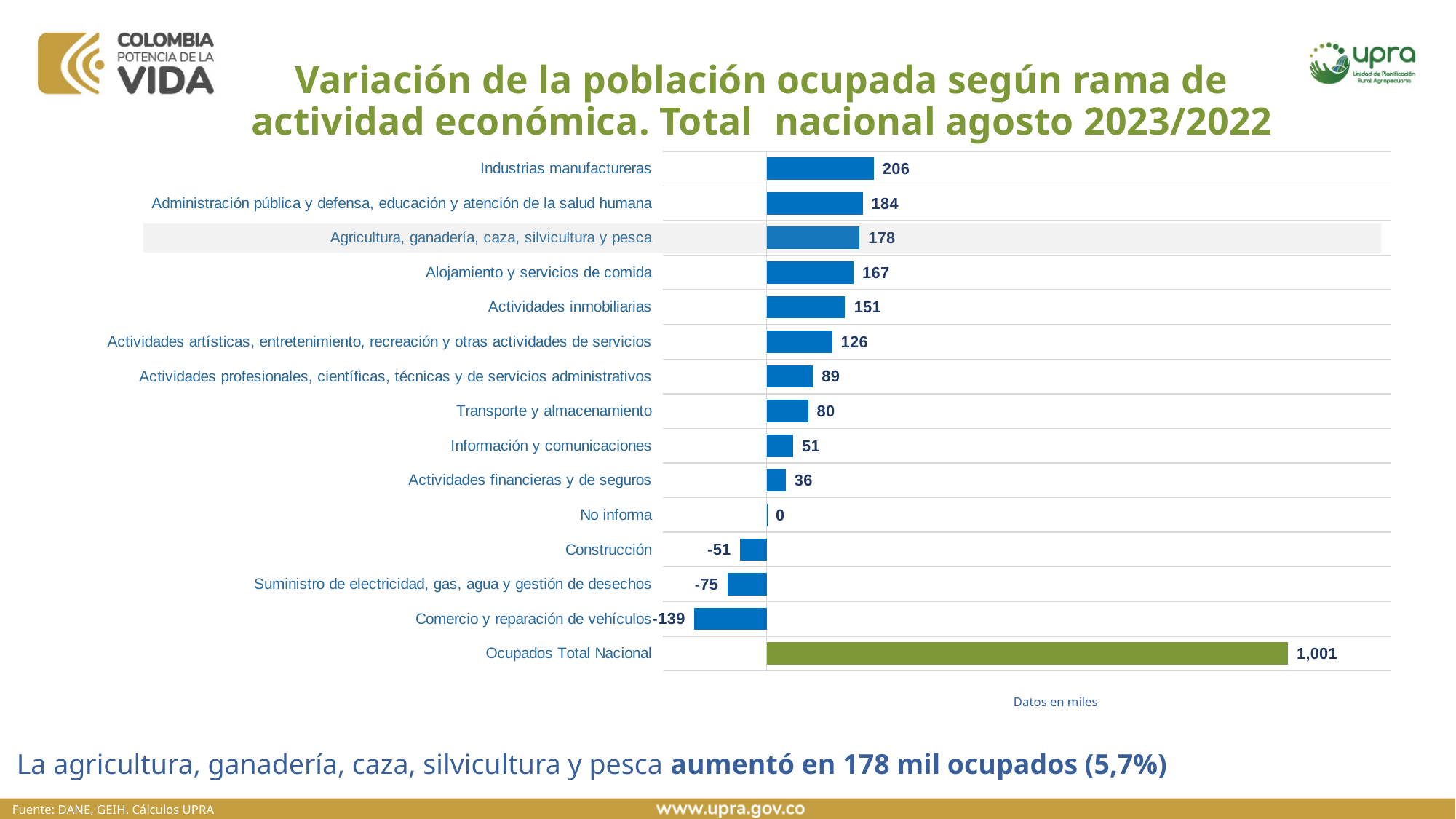
What is the value for Ocupados Total Nacional? 1,001 What is the difference between the values for Industrias manufactureras and Alojamiento y servicios de comida? 39 Which category has the lowest value? Comercio y reparación de vehículos Excluding Ocupados Total Nacional, which category has the highest value? Industrias manufactureras How many categories are shown in the chart? 15 What kind of chart is shown on the slide? Bar chart What is the value for Comercio y reparación de vehículos? -139 What is the value for Industrias manufactureras? 206 What is the value for Construcción? -51 What unit note is shown below the chart? Datos en miles What is the value for Agricultura, ganadería, caza, silvicultura y pesca? 178 Which is larger, the value for Transporte y almacenamiento or the value for Información y comunicaciones? Transporte y almacenamiento